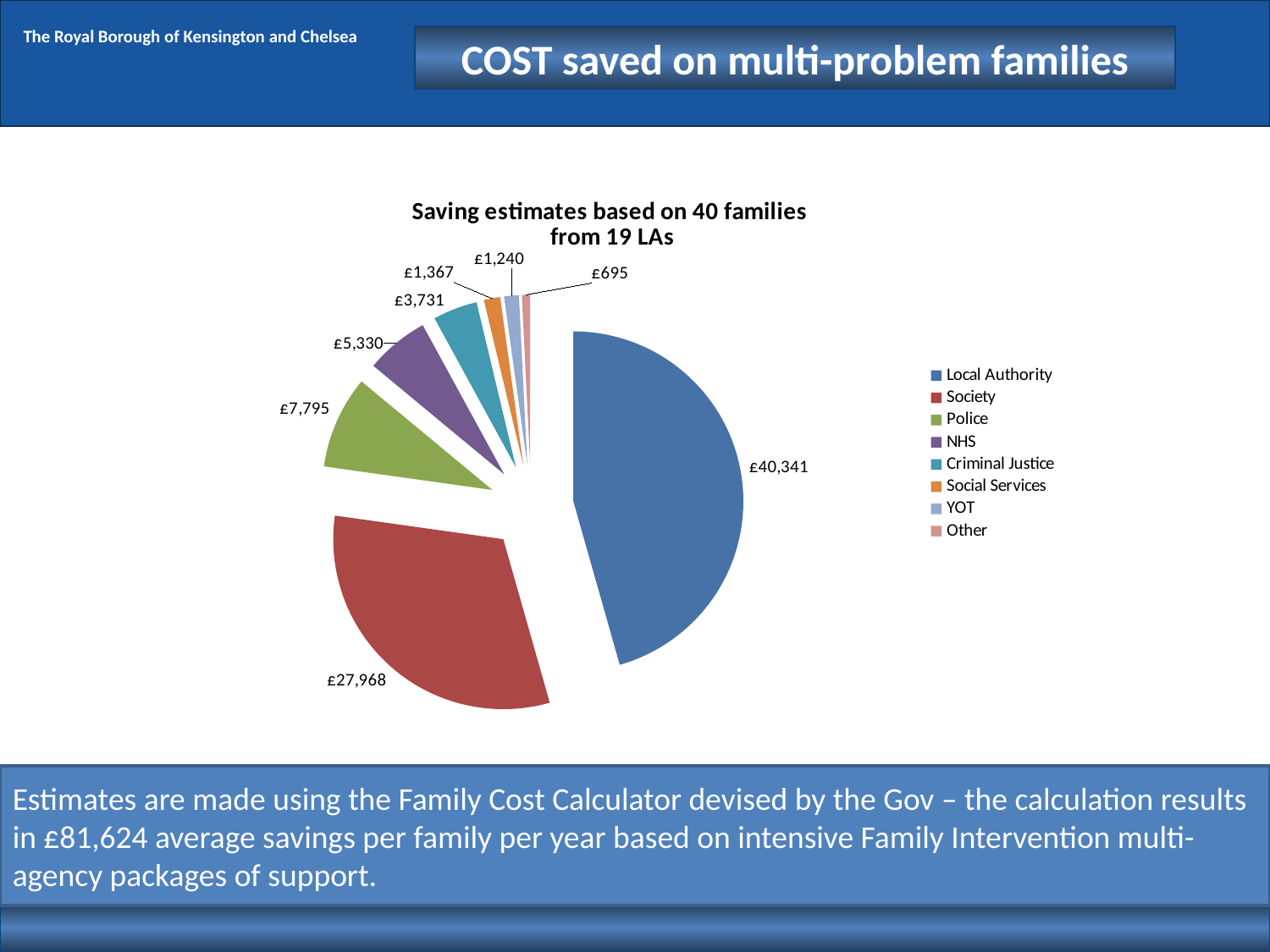
What is the saving estimate for Society? £27,968 Which has a larger saving estimate, Police or NHS? Police What is the saving estimate for Criminal Justice? £3,731 What is the saving estimate for Local Authority? £40,341 What is the saving estimate for NHS? £5,330 How many categories does the legend list? 8 Which category has the largest saving estimate? Local Authority What is the saving estimate for Police? £7,795 What type of chart is shown on the slide? Pie chart Which category has the smallest saving estimate? Other What is the difference between the Local Authority and Society saving estimates? £12,373 What is the title of the chart? Saving estimates based on 40 families from 19 LAs